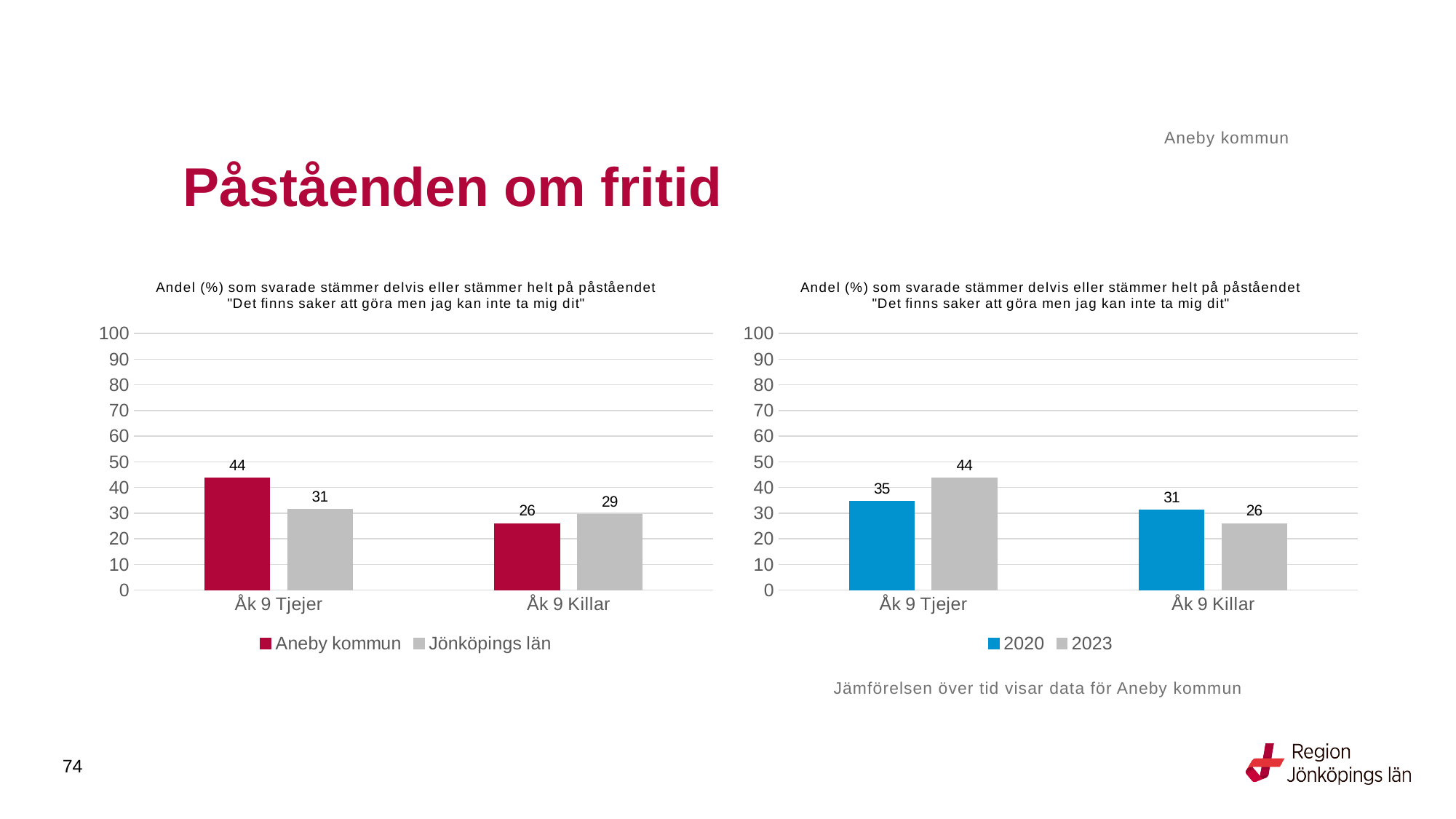
In the right chart, which is larger for Åk 9 Killar: 2020 or 2023? 2020 How many series does the legend of the right chart list? 2 In the right chart, what is the value for 2023 for Åk 9 Killar? 26 In the left chart, which is larger for Åk 9 Killar: Aneby kommun or Jönköpings län? Jönköpings län In the right chart, what is the value for 2020 for Åk 9 Tjejer? 35 In the right chart, which category has the highest value for 2023? Åk 9 Tjejer In the right chart, what is the difference between 2023 and 2020 for Åk 9 Tjejer? 9 In the left chart, what is the difference between Aneby kommun and Jönköpings län for Åk 9 Tjejer? 13 In the left chart, which category has the lowest value for Aneby kommun? Åk 9 Killar In the left chart, what is the value for Jönköpings län for Åk 9 Killar? 29 What kind of chart is the left chart? Bar chart In the left chart, what is the value for Aneby kommun for Åk 9 Tjejer? 44